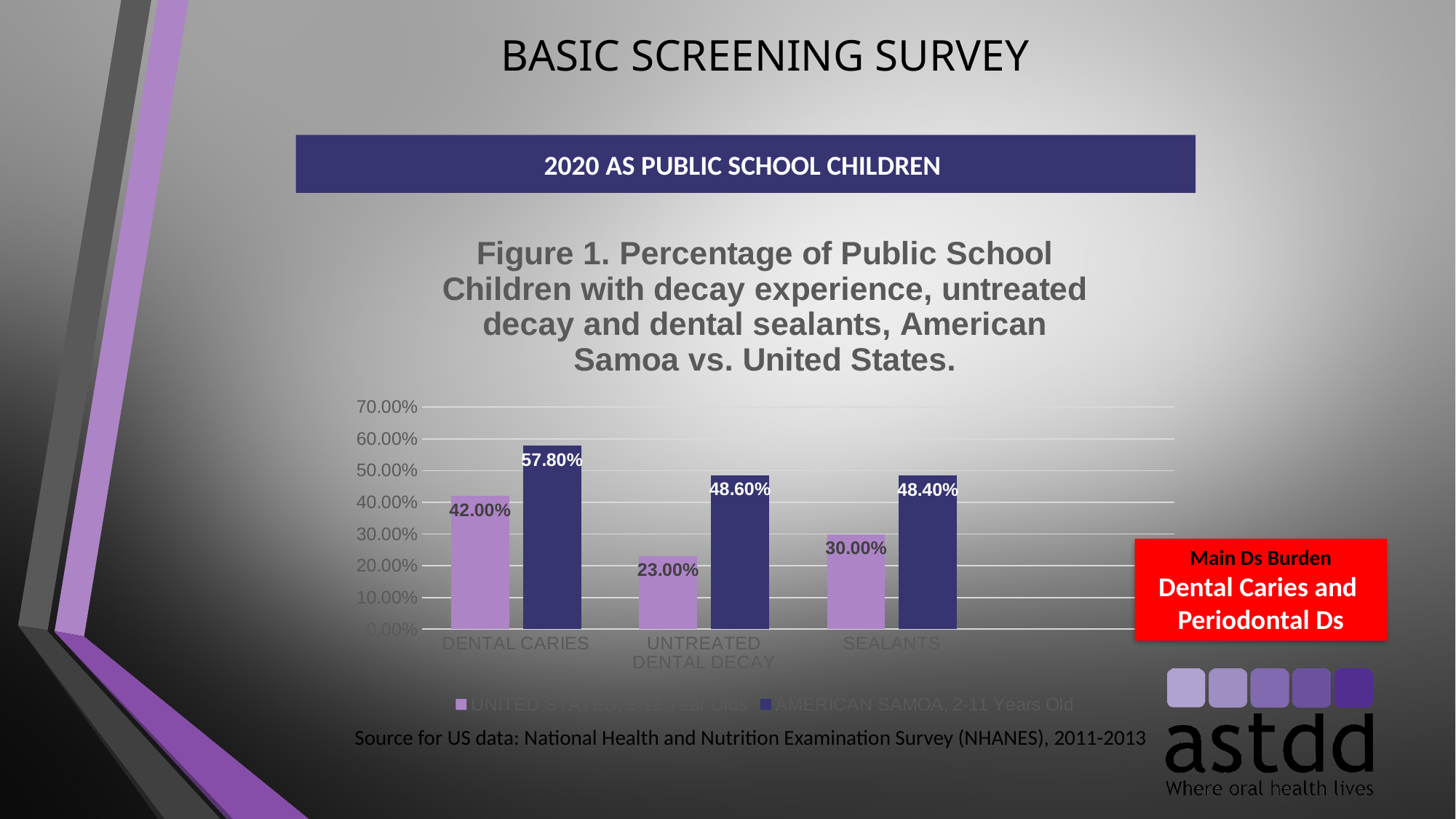
What is the difference between the American Samoa and United States values for Untreated Dental Decay? 25.60% Which is larger for Sealants: the United States value or the American Samoa value? American Samoa What is the value for American Samoa, 2-11 Years Old for Untreated Dental Decay? 48.60% What is the value for United States, 2-11 Year Olds for Sealants? 30.00% What kind of chart is shown on the slide? Bar chart How many series does the legend list? 2 What is the value for United States, 2-11 Year Olds for Untreated Dental Decay? 23.00% Which category has the lowest value for United States, 2-11 Year Olds? Untreated Dental Decay Which category has the highest value for American Samoa, 2-11 Years Old? Dental Caries What is the value for American Samoa, 2-11 Years Old for Dental Caries? 57.80% How many categories are shown on the x axis? 3 What is the difference between the American Samoa and United States values for Dental Caries? 15.80%